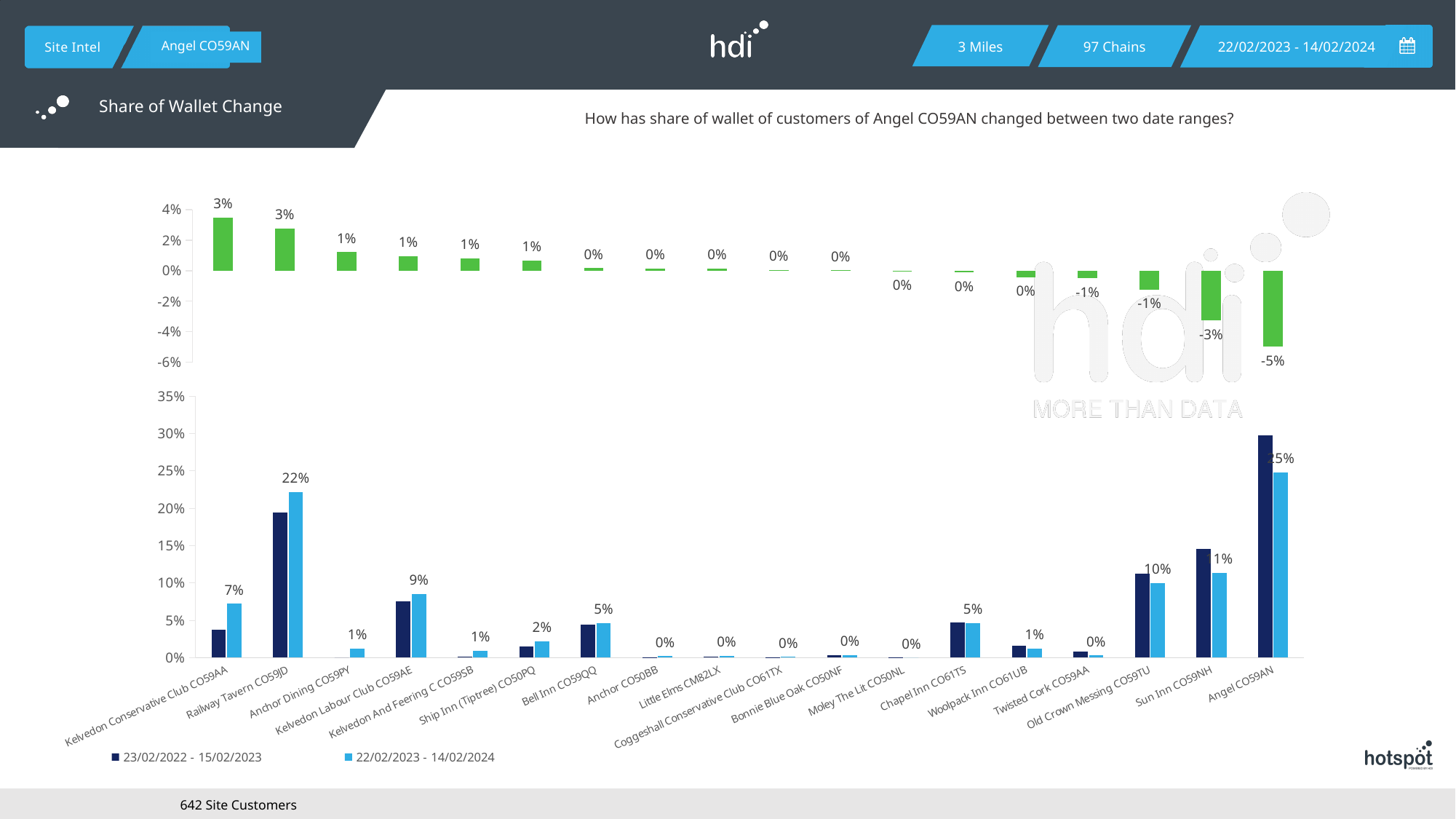
On the bottom chart, is the value for Angel CO59AN in the 23/02/2022 - 15/02/2023 series greater or less than 25%? greater On the bottom chart, how many categories are shown on the x axis? 18 On the bottom chart, what is the value for Railway Tavern CO59JD in the 22/02/2023 - 14/02/2024 series? 22% On the bottom chart, which category has the highest value in the 22/02/2023 - 14/02/2024 series? Angel CO59AN What kind of chart is the bottom chart? bar chart On the top chart (share of wallet change), what is the value for Sun Inn CO59NH? -3% On the bottom chart, what is the difference between Angel CO59AN and Railway Tavern CO59JD in the 22/02/2023 - 14/02/2024 series? 3% On the bottom chart, how many series does the legend list? 2 On the bottom chart, which is larger in the 22/02/2023 - 14/02/2024 series: Old Crown Messing CO59TU or Sun Inn CO59NH? Sun Inn CO59NH On the top chart (share of wallet change), which category has the lowest value? Angel CO59AN On the top chart (share of wallet change), what is the value for Angel CO59AN? -5% On the top chart (share of wallet change), what is the value for Kelvedon Labour Club CO59AE? 1%